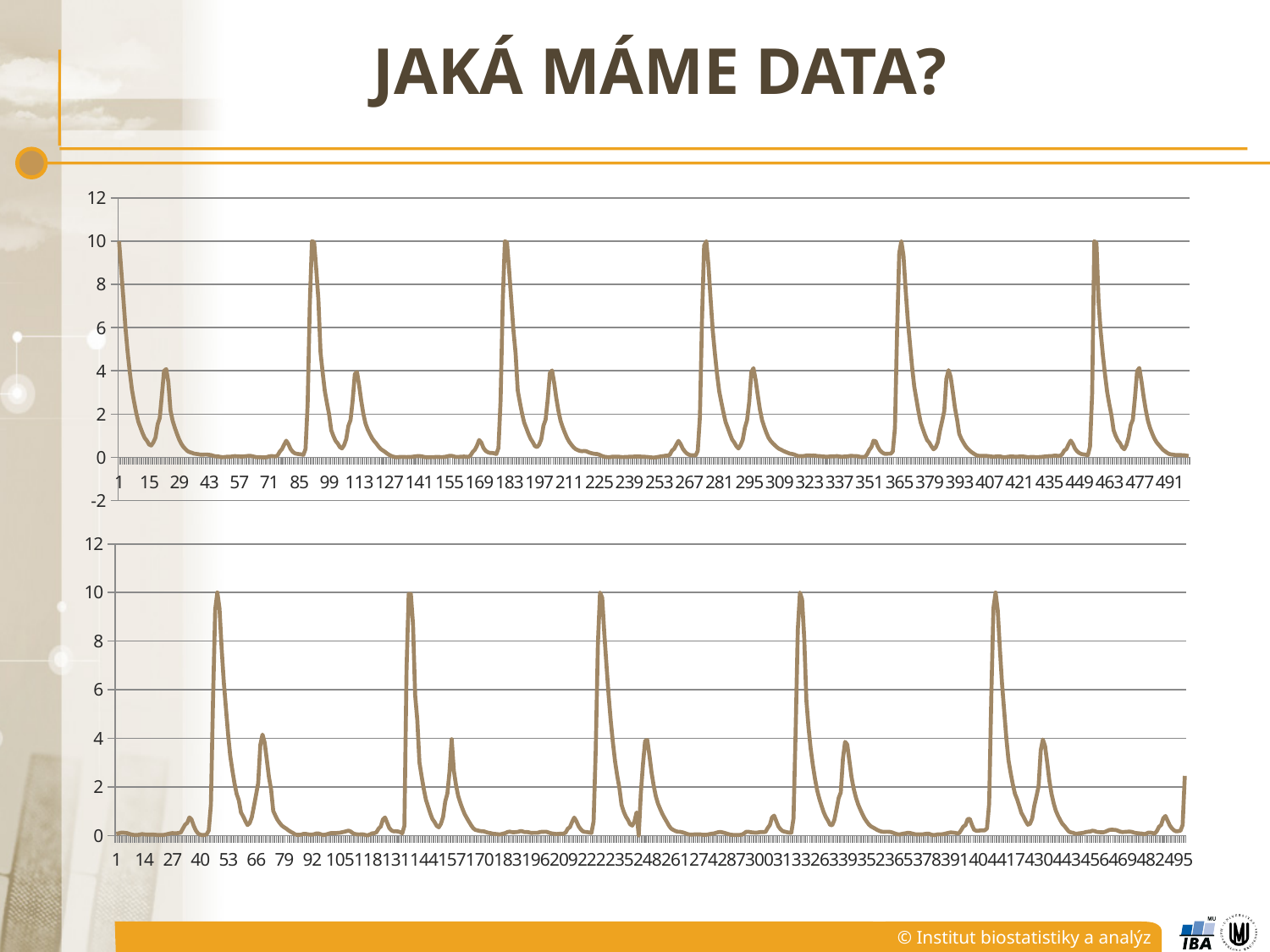
In the top chart, is the value at the tallest peaks greater or less than 8? greater How many charts are shown on the slide? 2 In the bottom chart, is the value at the smaller secondary peaks greater or less than 6? less What kind of chart is the top chart on the slide? line chart What kind of chart is the bottom chart on the slide? line chart In the top chart, what is the lowest label shown on the y axis? -2 In the top chart, how many large peaks reach the 10 gridline? 6 In the top chart, is the value at the smaller secondary peaks greater or less than 2? greater In the bottom chart, what is the highest label shown on the y axis? 12 In the bottom chart, what is the last label shown on the x axis? 495 In the top chart, what is the last label shown on the x axis? 491 In the bottom chart, how many large peaks reach the 10 gridline? 5